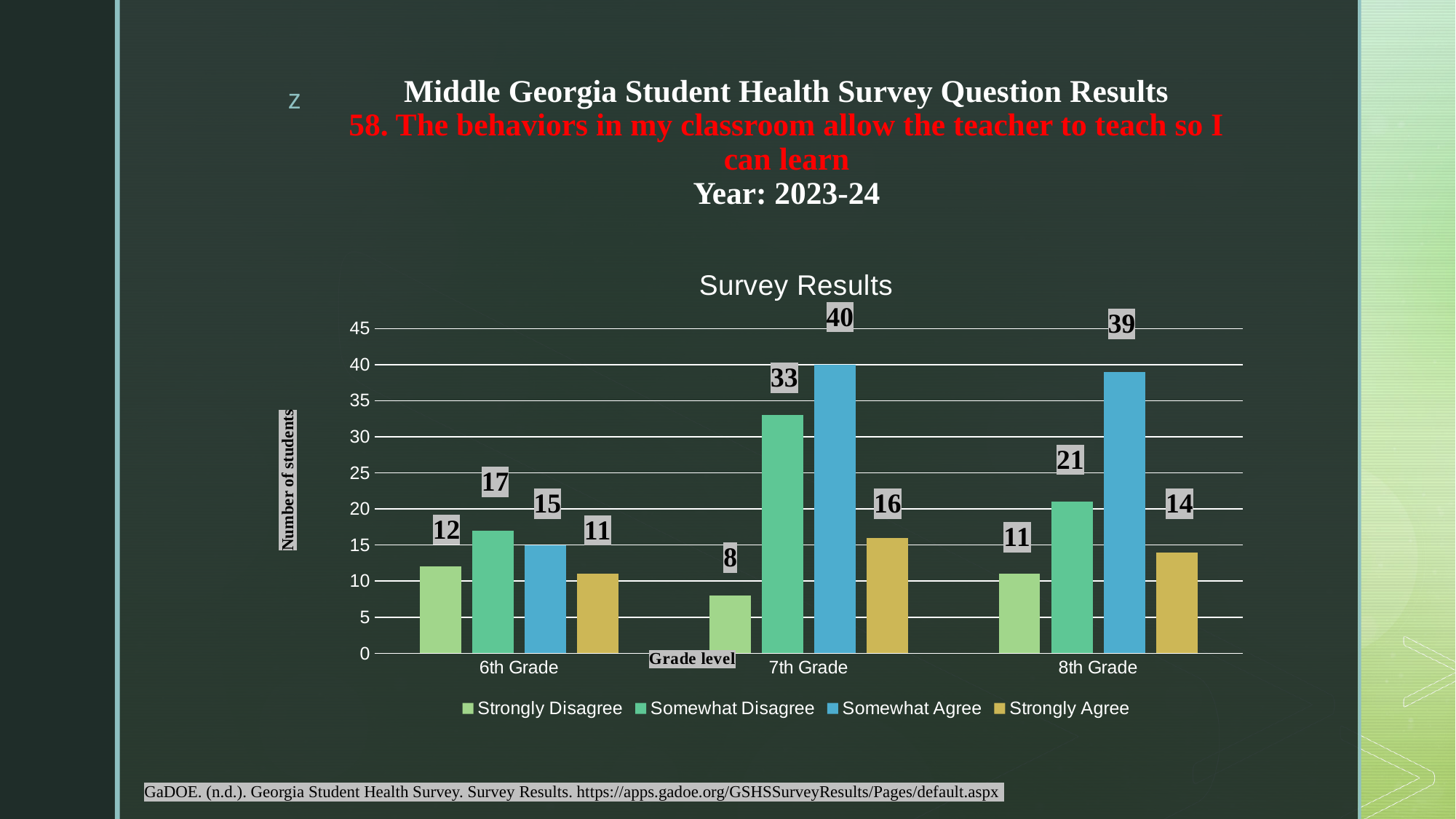
What is the value for Strongly Disagree in 6th Grade? 12 How many grade levels are shown on the x axis? 3 What is the difference between Somewhat Agree and Somewhat Disagree in 8th Grade? 18 How many series does the legend list? 4 What is the value for Strongly Agree in 8th Grade? 14 What is the value for Somewhat Agree in 7th Grade? 40 What kind of chart is shown? Bar chart What is the title of the chart? Survey Results Is the value for Somewhat Disagree in 7th Grade greater or less than 30? greater Which is larger: Strongly Agree in 7th Grade or Strongly Agree in 6th Grade? 7th Grade Which grade has the lowest Strongly Disagree value? 7th Grade Which grade has the highest Somewhat Agree value? 7th Grade